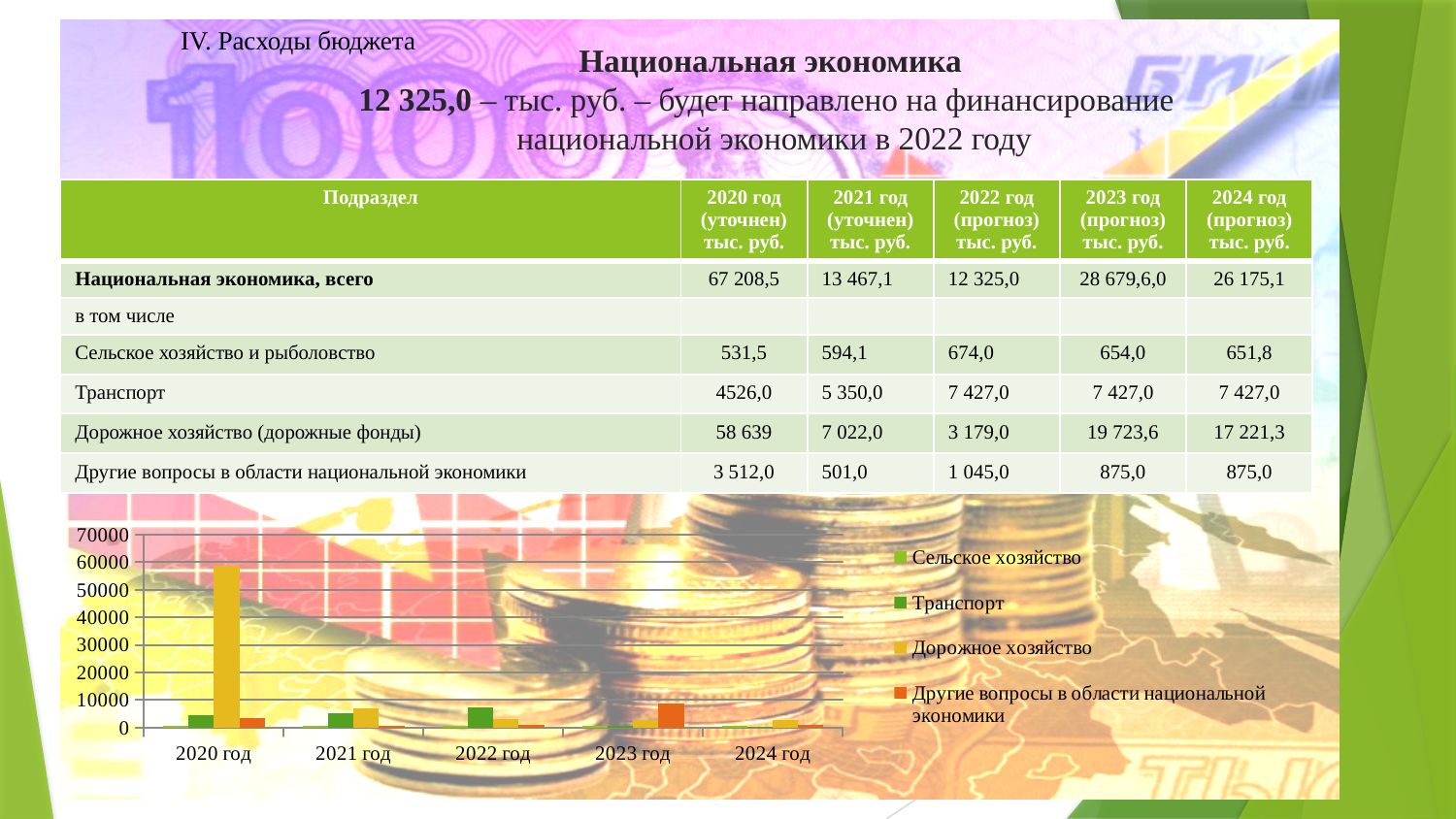
In 2020 год, which is larger: Дорожное хозяйство or Транспорт? Дорожное хозяйство Is the value for Транспорт in 2022 год greater or less than 10000? less How many year categories are shown on the x axis of the chart? 5 In 2021 год, which is larger: Дорожное хозяйство or Транспорт? Дорожное хозяйство According to the slide, what is the value for Транспорт in 2022 год (тыс. руб.)? 7 427,0 Which year has the tallest bar in the chart? 2020 год What kind of chart is shown at the bottom of the slide? bar chart Is the value for Дорожное хозяйство in 2020 год greater or less than 50000? greater What is the last entry listed in the chart legend? Другие вопросы в области национальной экономики What is the highest tick value shown on the chart's vertical axis? 70000 How many series does the chart legend list? 4 Does the value for Дорожное хозяйство rise or fall from 2020 год to 2022 год? fall